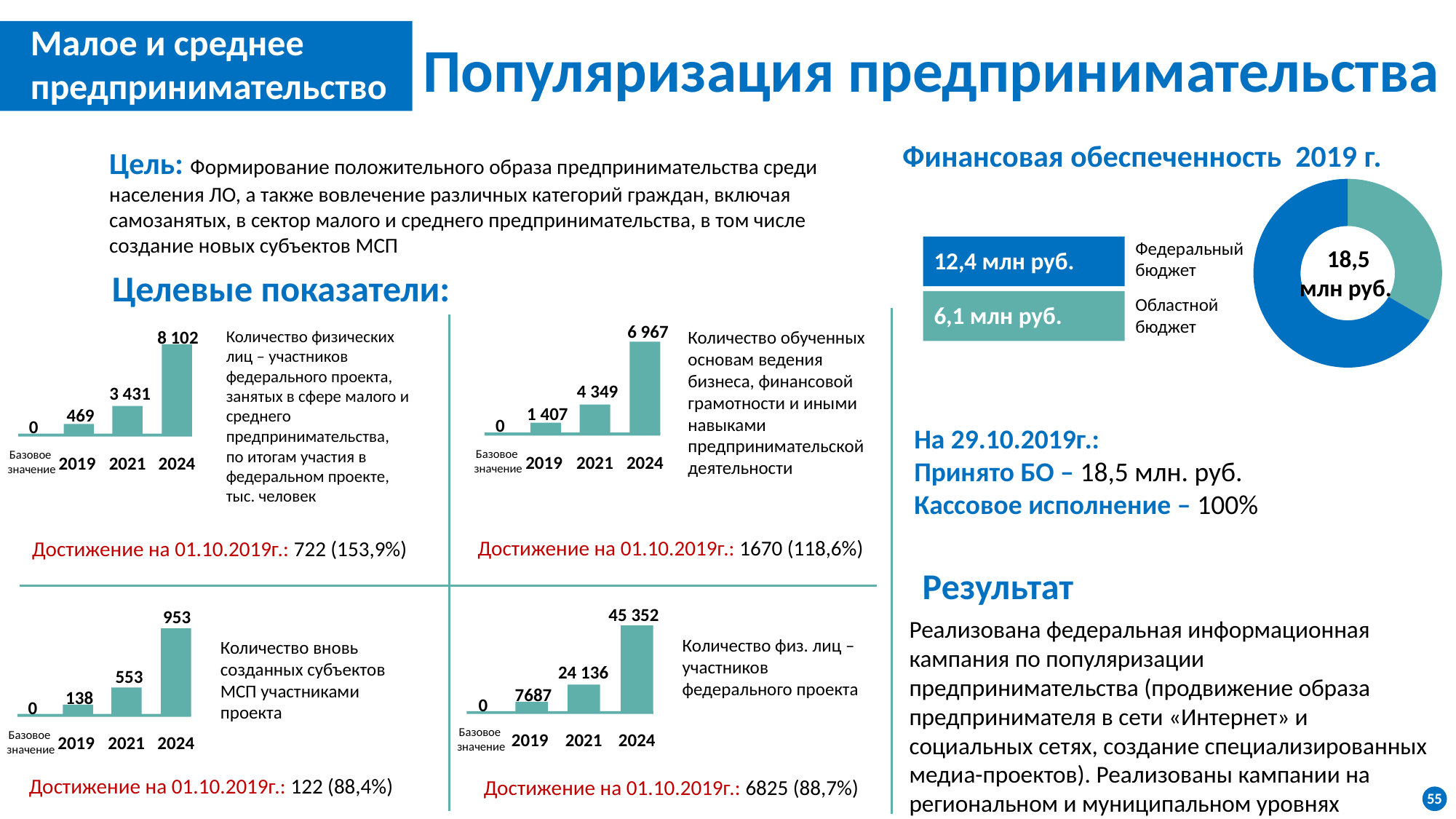
In the top-right bar chart (Количество обученных основам ведения бизнеса), which year has the highest value? 2024 In the bottom-left bar chart (Количество вновь созданных субъектов МСП), what is the value for 2019? 138 In the top-left bar chart (Количество физических лиц – участников федерального проекта), what is the value for 2019? 469 In the top-right bar chart (Количество обученных основам ведения бизнеса), what is the value for 2021? 4 349 In the donut chart Финансовая обеспеченность 2019 г., what is the value for Федеральный бюджет? 12,4 млн руб. In the top-left bar chart (Количество физических лиц – участников федерального проекта), what is the value for 2024? 8 102 What is the total shown in the centre of the donut chart Финансовая обеспеченность 2019 г.? 18,5 млн руб. In the donut chart Финансовая обеспеченность 2019 г., which is larger: Федеральный бюджет or Областной бюджет? Федеральный бюджет In the bottom-right bar chart (Количество физ. лиц – участников федерального проекта), do the values rise or fall from the base value to 2024? rise In the bottom-right bar chart (Количество физ. лиц – участников федерального проекта), what is the value for 2024? 45 352 In the bottom-left bar chart (Количество вновь созданных субъектов МСП), what is the difference between the 2024 and 2021 values? 400